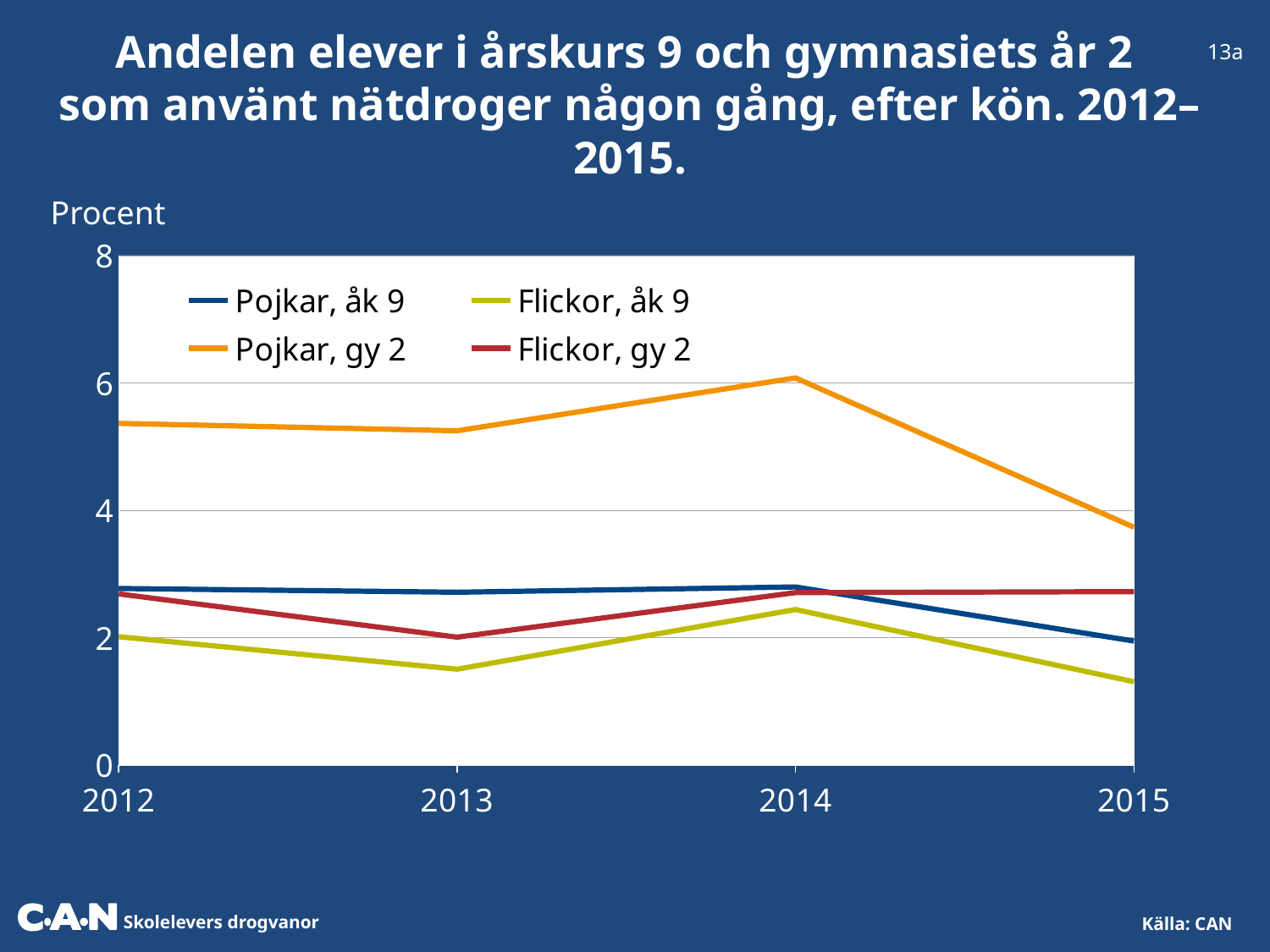
Is the value for Pojkar, åk 9 in 2012 greater or less than 2? greater Is the value for Pojkar, gy 2 in 2012 greater or less than 4? greater Which is larger in 2012, the value for Pojkar, gy 2 or the value for Flickor, åk 9? Pojkar, gy 2 What kind of chart is shown on the slide? line chart What label is shown above the y axis? Procent Which series has the lowest value in 2015? Flickor, åk 9 Is the value for Flickor, åk 9 in 2013 greater or less than 2? less How many series does the legend list? 4 How many years are shown on the x axis? 4 Which series has the highest value in 2014? Pojkar, gy 2 Does the value for Pojkar, gy 2 rise or fall from 2014 to 2015? fall